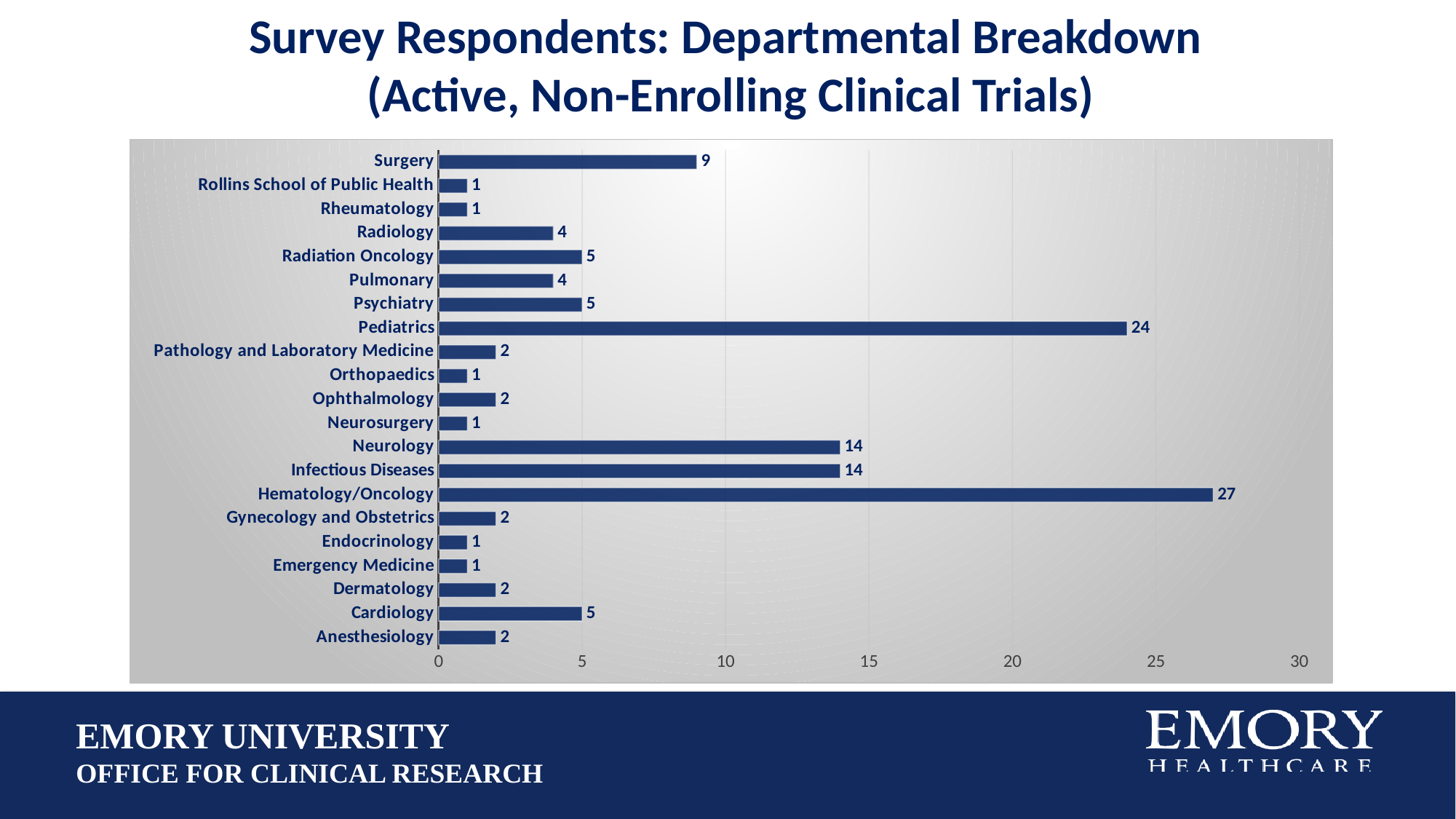
How many respondents are from Pediatrics? 24 Which is larger, the value for Cardiology or the value for Dermatology? Cardiology What type of chart is shown on the slide? bar chart What is the title of the slide? Survey Respondents: Departmental Breakdown (Active, Non-Enrolling Clinical Trials) Is the value for Pediatrics greater or less than 20? greater What is the difference between the values for Neurology and Surgery? 5 Which department has the highest number of respondents? Hematology/Oncology What is the value for Radiation Oncology? 5 What is the value for Hematology/Oncology? 27 What is the value for Surgery? 9 How many departments are shown in the chart? 21 What is the difference between the values for Hematology/Oncology and Pediatrics? 3